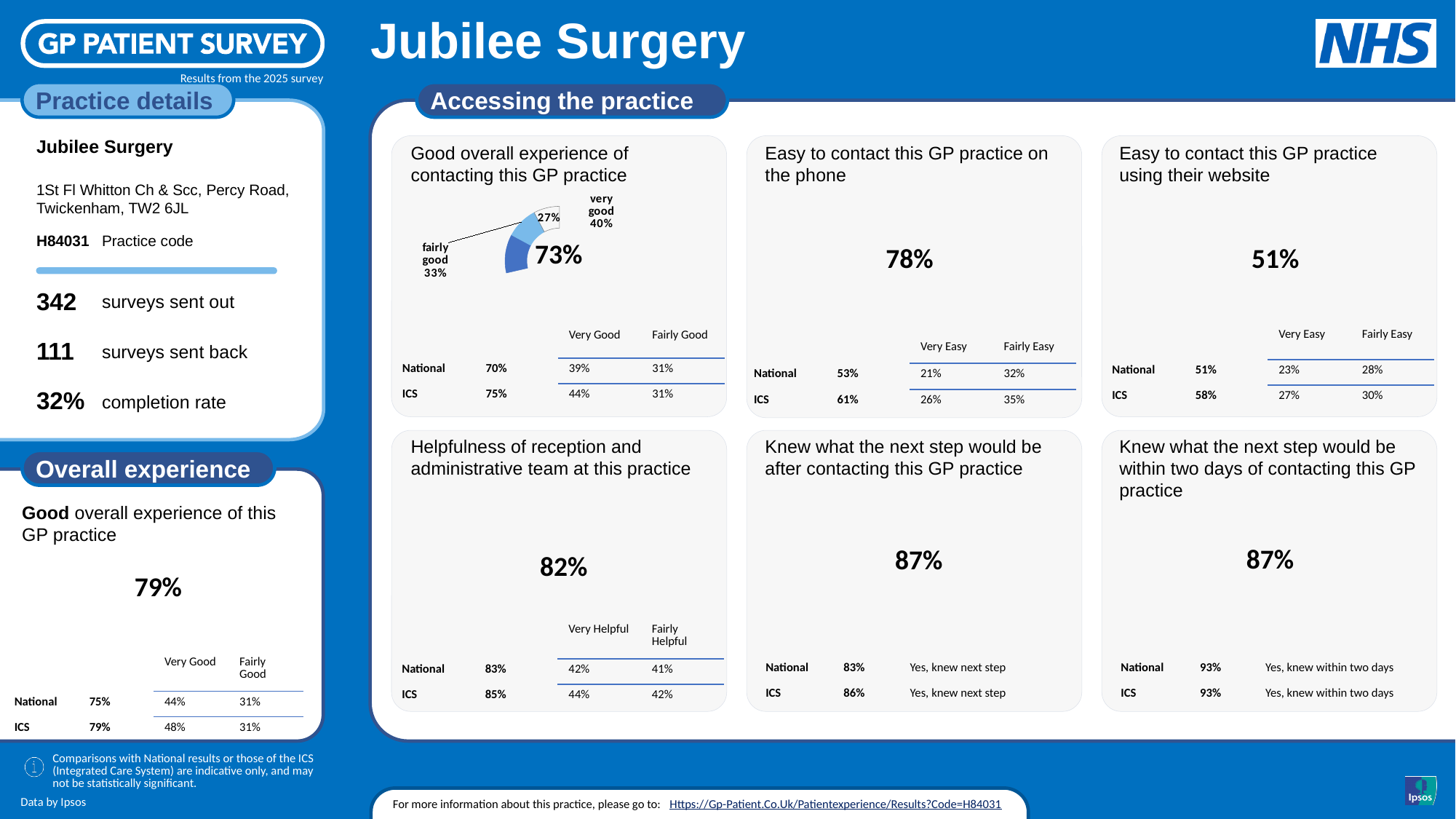
In the 'Good overall experience of contacting this GP practice' chart, what percentage is shown on the unlabelled segment at the top? 27% In the 'Good overall experience of contacting this GP practice' chart, what percentage is labelled 'very good'? 40% What is the title of the panel containing the pie chart on this slide? Good overall experience of contacting this GP practice In the 'Good overall experience of contacting this GP practice' chart, what do the 'very good' and 'fairly good' percentages add up to? 73% In the 'Good overall experience of contacting this GP practice' chart, is the 'fairly good' value greater or less than 30%? greater In the 'Good overall experience of contacting this GP practice' chart, what percentage is labelled 'fairly good'? 33% In the 'Good overall experience of contacting this GP practice' chart, which is larger: 'very good' or 'fairly good'? very good What kind of chart is shown in the 'Good overall experience of contacting this GP practice' panel? pie chart What is the large percentage printed in the centre of the 'Good overall experience of contacting this GP practice' chart? 73% In the 'Good overall experience of contacting this GP practice' chart, what is the difference between the 'very good' and 'fairly good' percentages? 7%